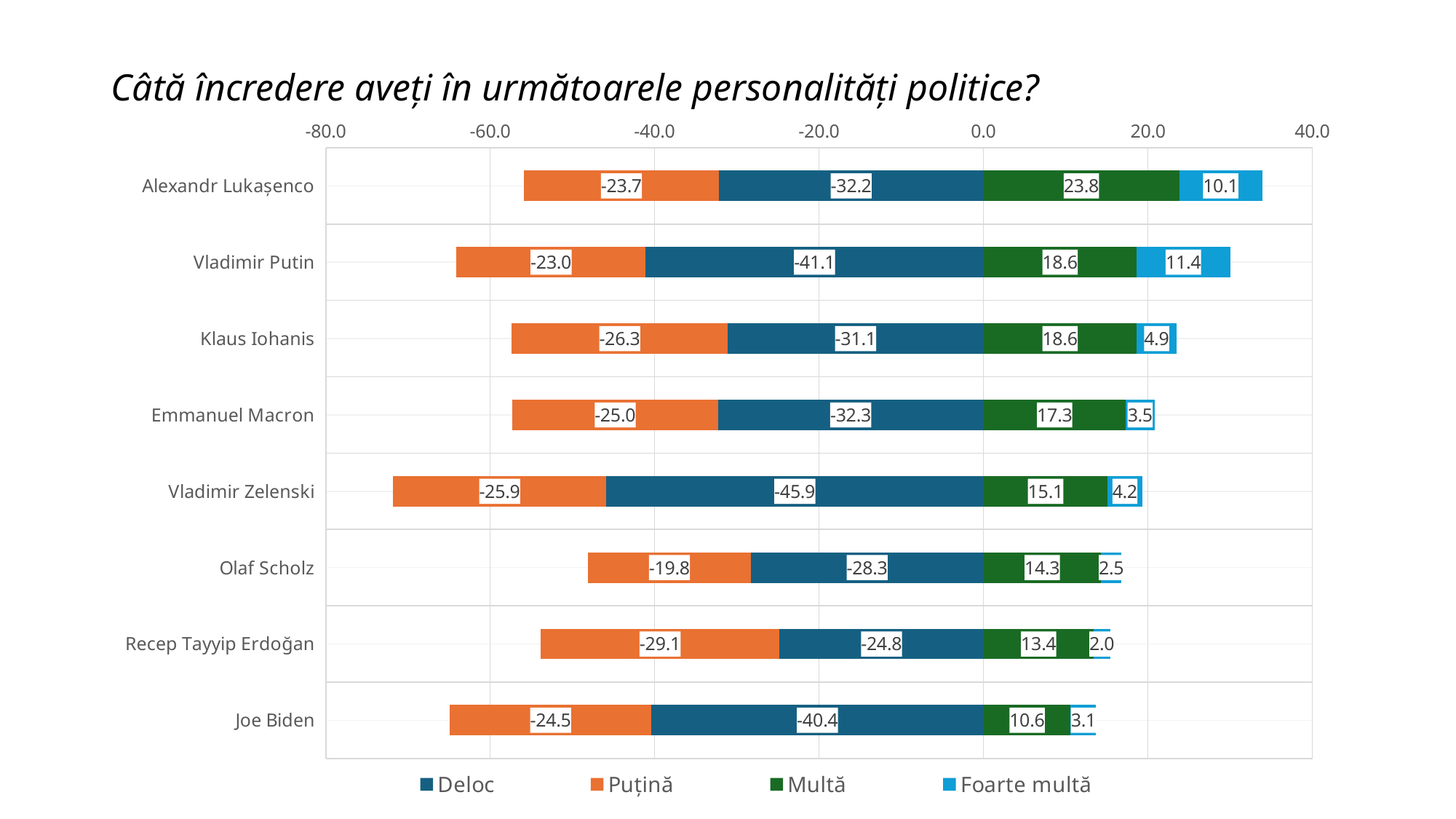
What is the value of the Deloc series for Vladimir Putin? -41.1 How many politicians are shown on the chart? 8 Who has the larger Multă value, Klaus Iohanis or Emmanuel Macron? Klaus Iohanis What type of chart is shown on the slide? Bar chart What is the difference between the Multă values for Alexandr Lukașenco and Vladimir Putin? 5.2 Which politician has the highest value in the Multă series? Alexandr Lukașenco What is the value of the Puțină series for Recep Tayyip Erdoğan? -29.1 Which politician has the lowest value in the Multă series? Joe Biden Which politician has the highest value in the Foarte multă series? Vladimir Putin Which politician has the lowest value in the Foarte multă series? Recep Tayyip Erdoğan How many series does the legend list? 4 What is the value of the Foarte multă series for Alexandr Lukașenco? 10.1